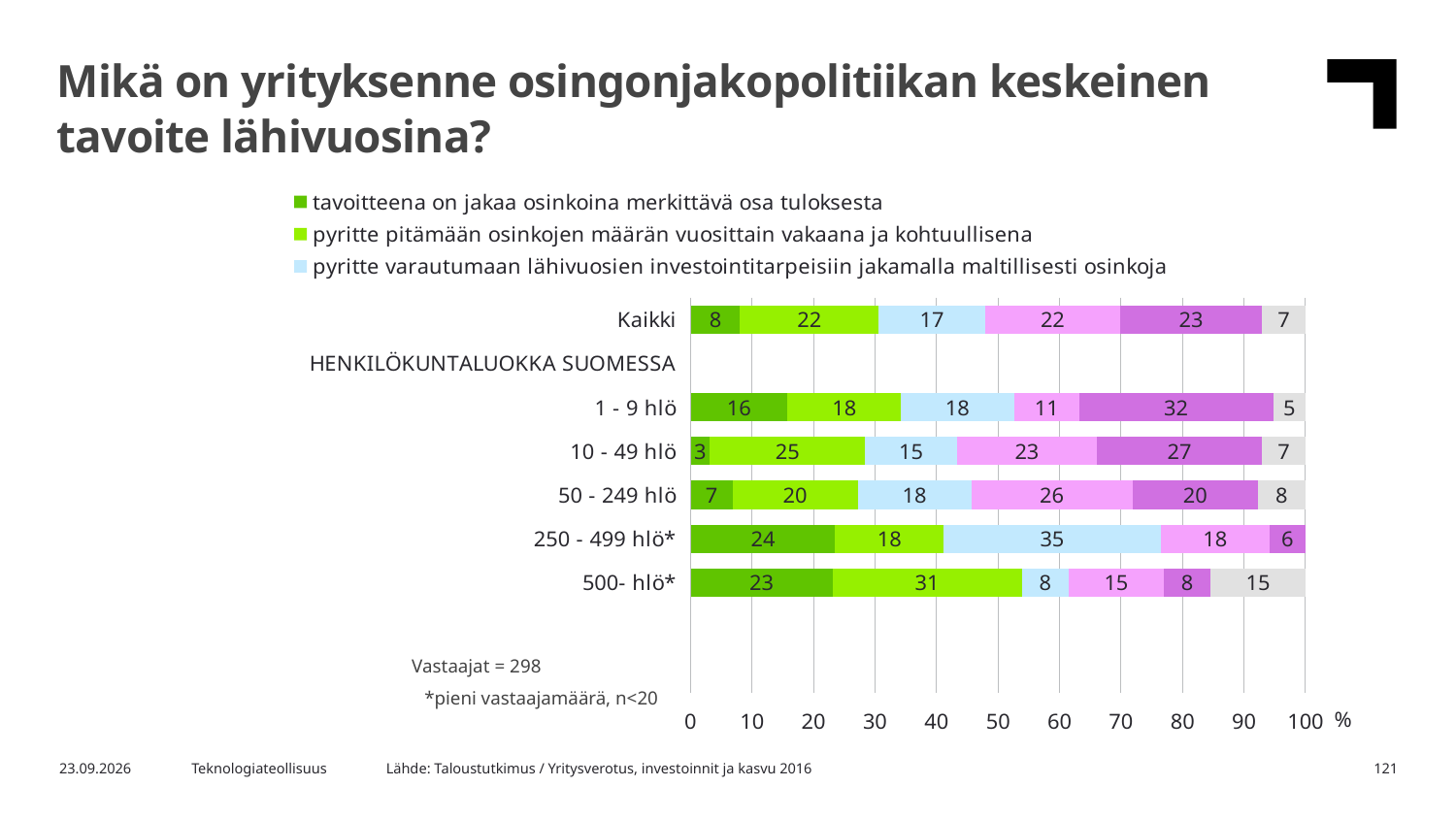
What is the value for "50 - 249 hlö" in the series "pyritte varautumaan lähivuosien investointitarpeisiin jakamalla maltillisesti osinkoja"? 18 How many categories have bars plotted in the chart? 6 Which category has the lowest value in the series "tavoitteena on jakaa osinkoina merkittävä osa tuloksesta"? 10 - 49 hlö What is the value for "Kaikki" in the series "tavoitteena on jakaa osinkoina merkittävä osa tuloksesta"? 8 What is the value for "250 - 499 hlö*" in the series "pyritte varautumaan lähivuosien investointitarpeisiin jakamalla maltillisesti osinkoja"? 35 How many respondents (Vastaajat) does the chart note? 298 What kind of chart is shown on the slide? Stacked bar chart How much larger is the value for "1 - 9 hlö" than for "Kaikki" in the series "tavoitteena on jakaa osinkoina merkittävä osa tuloksesta"? 8 How many series does the legend list? 3 In the series "pyritte pitämään osinkojen määrän vuosittain vakaana ja kohtuullisena", which is larger: "10 - 49 hlö" or "50 - 249 hlö"? 10 - 49 hlö Which category has the highest value in the series "tavoitteena on jakaa osinkoina merkittävä osa tuloksesta"? 250 - 499 hlö* What is the value for "500- hlö*" in the series "pyritte pitämään osinkojen määrän vuosittain vakaana ja kohtuullisena"? 31